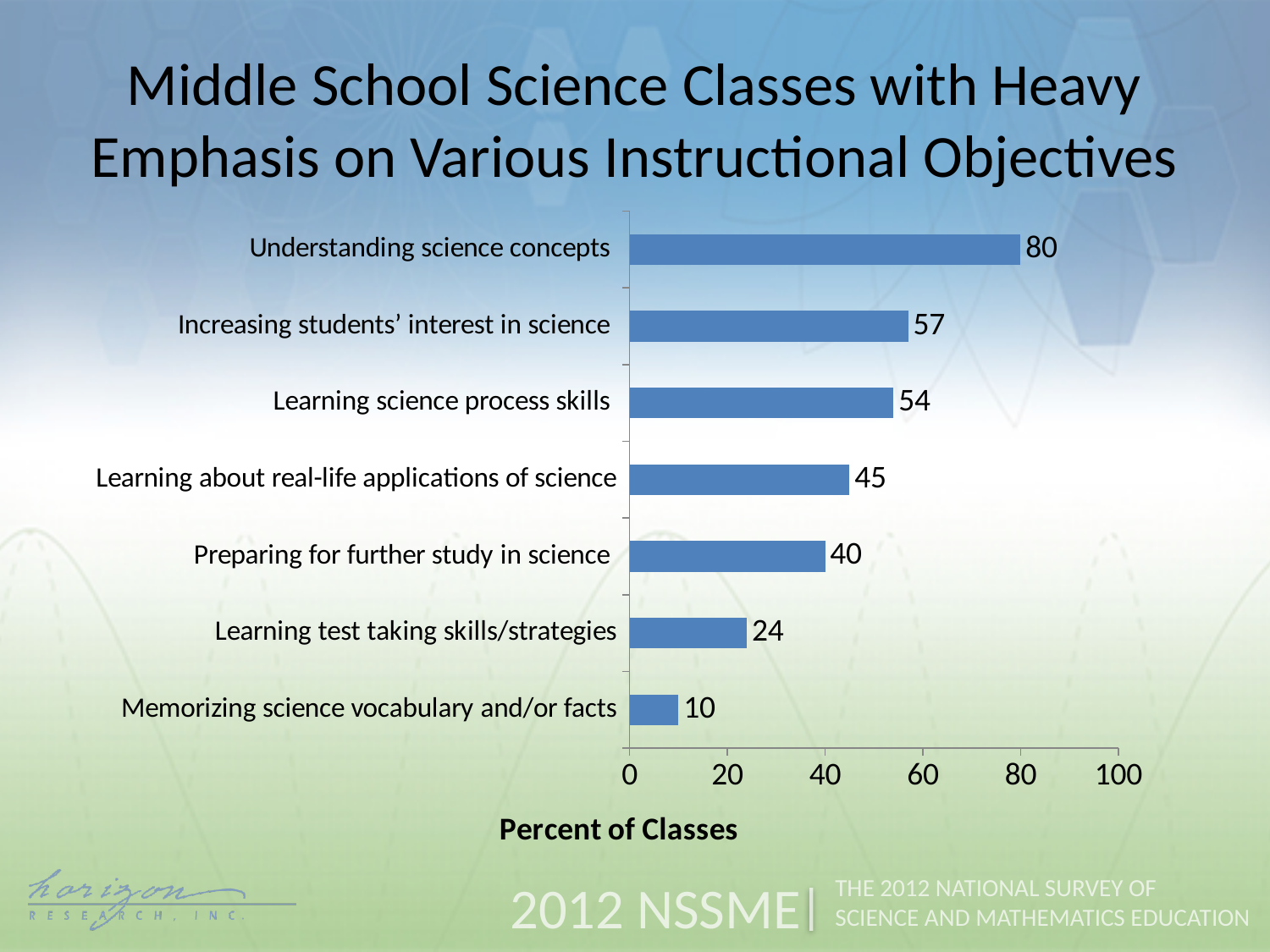
What is the value for Preparing for further study in science? 40 Which is larger: the value for Learning about real-life applications of science or Preparing for further study in science? Learning about real-life applications of science What is the label of the horizontal axis? Percent of Classes What is the difference between the values for Understanding science concepts and Memorizing science vocabulary and/or facts? 70 How many instructional objectives are shown in the chart? 7 Which instructional objective has the highest percent of classes? Understanding science concepts Is the value for Learning science process skills greater or less than 60? less What is the difference between the values for Increasing students' interest in science and Learning science process skills? 3 Which instructional objective has the lowest percent of classes? Memorizing science vocabulary and/or facts What kind of chart is shown on the slide? bar chart What percent of classes have a heavy emphasis on understanding science concepts? 80 What is the value for Learning test taking skills/strategies? 24